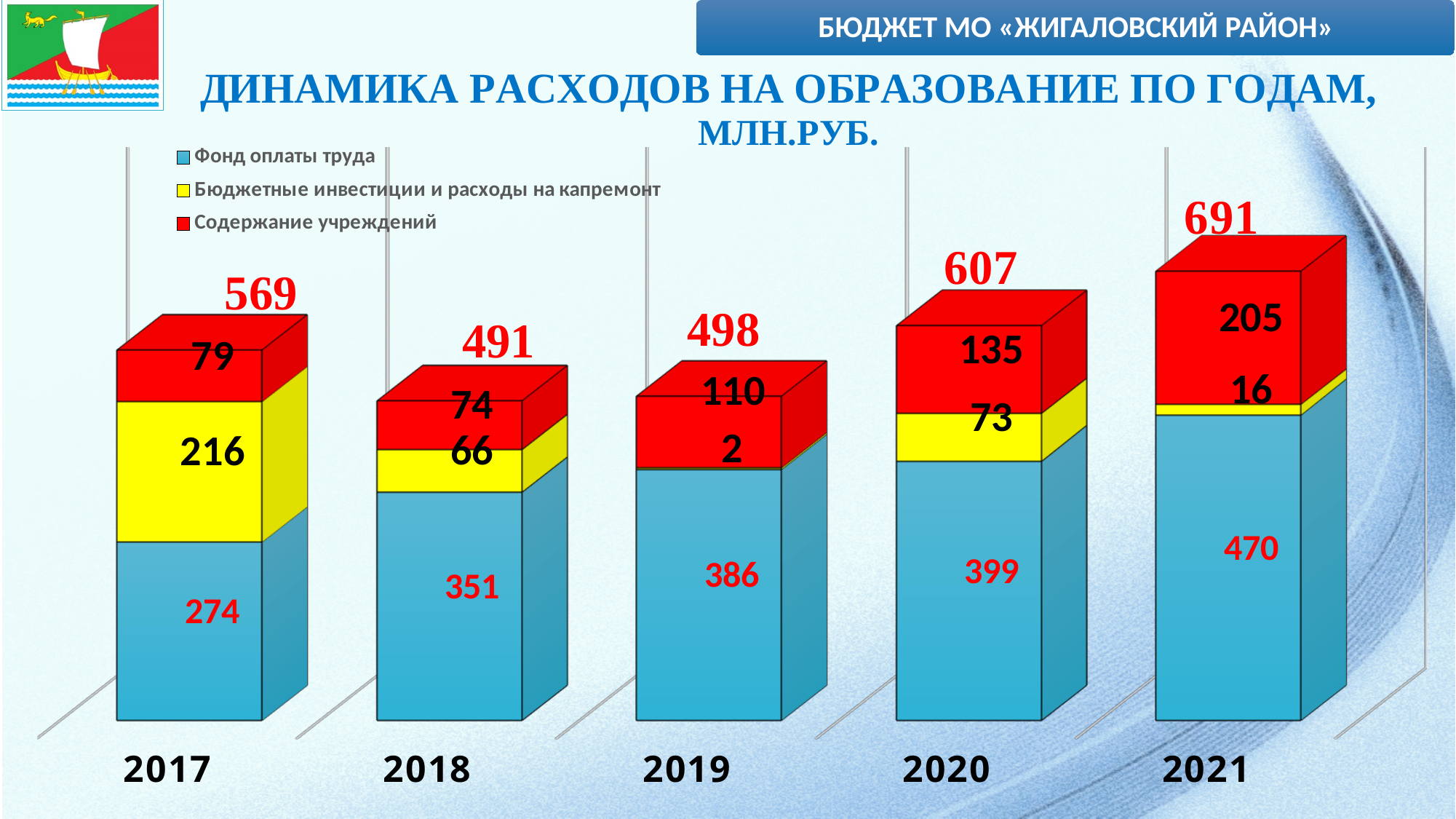
How many series does the legend list? 3 What is the value of Фонд оплаты труда for 2021? 470 What is the value of Содержание учреждений for 2020? 135 Which series is shown in yellow in the legend? Бюджетные инвестиции и расходы на капремонт What is the value of Бюджетные инвестиции и расходы на капремонт for 2017? 216 How many years are shown on the x axis? 5 Which year has the lowest total expenditure? 2018 Which year has the highest total expenditure? 2021 Which is larger: Содержание учреждений in 2019 or in 2018? 2019 What is the total of the stacked bar for 2019? 498 What kind of chart is shown on the slide? Stacked bar chart What is the difference between the Фонд оплаты труда values for 2021 and 2017? 196